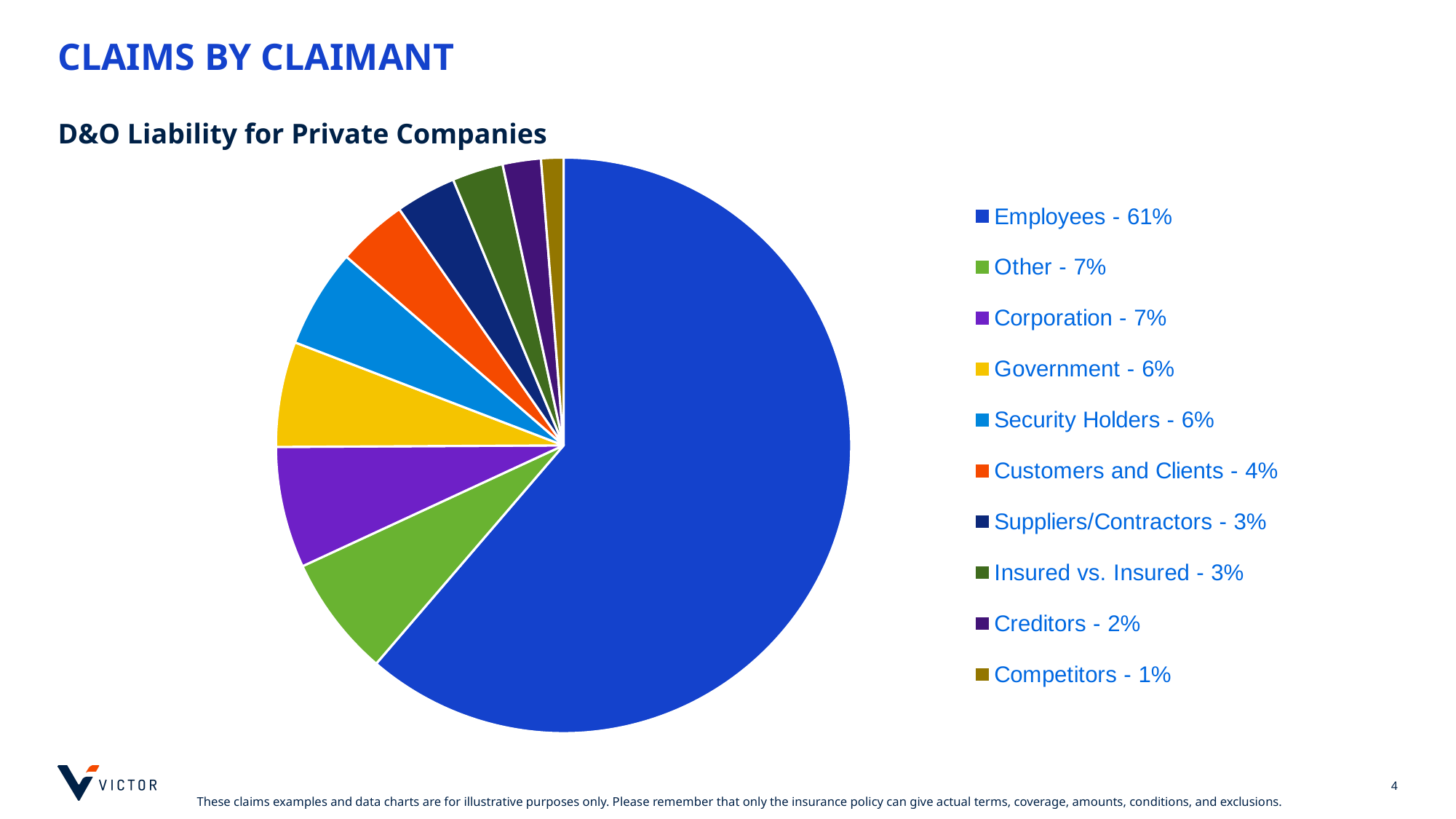
What is the difference in share between Security Holders and Creditors? 4% Which claimant category has the largest share of claims? Employees How many claimant categories are shown in the pie chart? 10 What is the subtitle shown above the pie chart? D&O Liability for Private Companies What share of claims is attributed to Employees? 61% What is the difference in share between Employees and Other? 54% What colour is the slice for Government? Yellow What share of claims is attributed to Customers and Clients? 4% What share of claims is attributed to Government? 6% Which claimant category has the smallest share of claims? Competitors Which has a larger share of claims, Customers and Clients or Insured vs. Insured? Customers and Clients What type of chart is shown on the slide? Pie chart